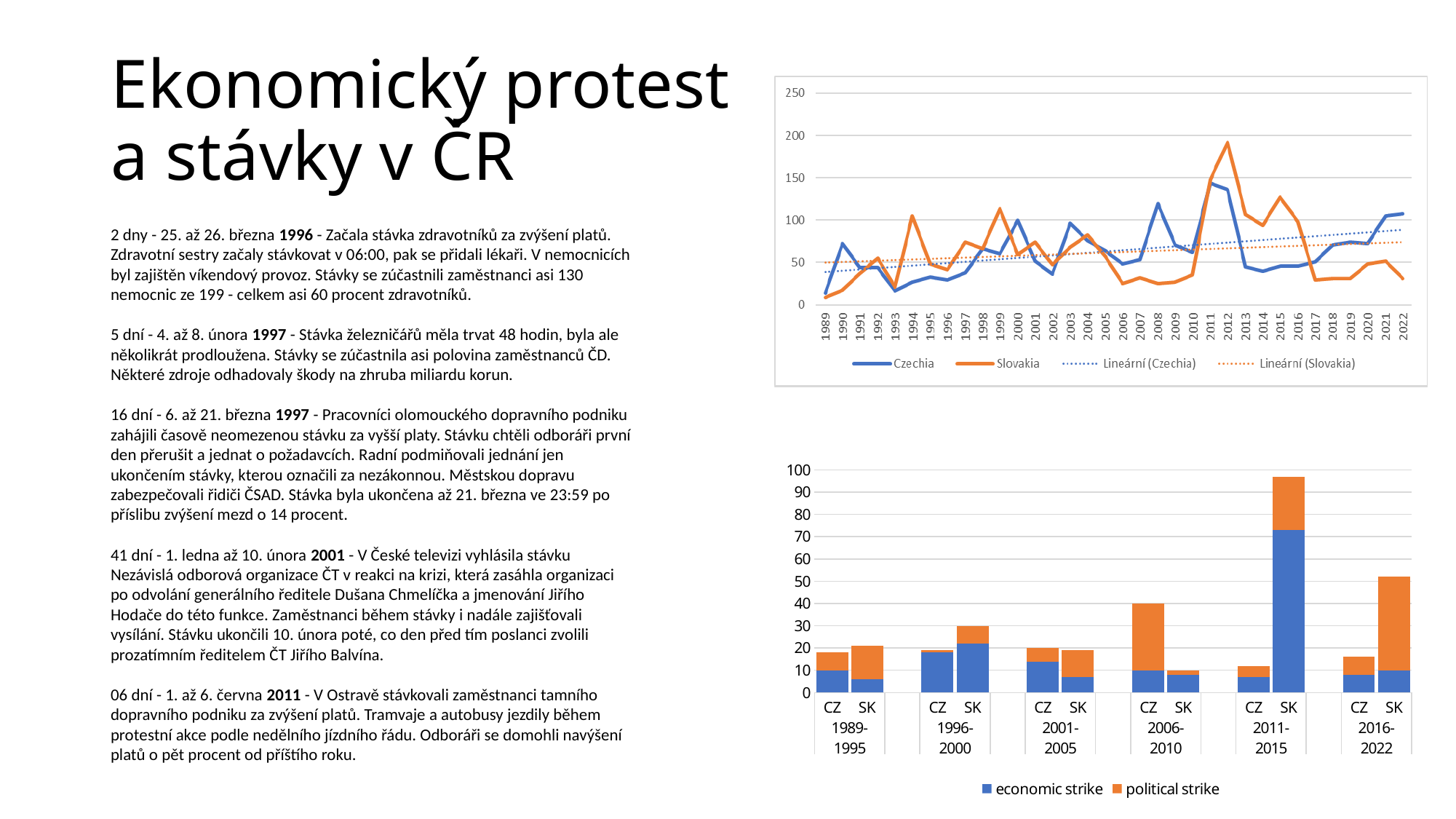
In the top line chart, is the value for Slovakia in 2022 greater or less than 50? less In the top line chart, do the linear trendlines for Czechia and Slovakia rise or fall over the years? rise In the bottom bar chart, which is larger in 2011-2015, the total for CZ or for SK? SK In the top line chart, in which year does the Slovakia series reach its highest value? 2012 In the top line chart, is the value for Slovakia in 2012 greater or less than 150? greater In the bottom bar chart, which bar has the highest total? SK 2011-2015 In the bottom bar chart, is the total for SK 2011-2015 greater or less than 90? greater In the bottom bar chart, how many series does the legend list? 2 What kind of chart is the bottom chart on the slide? bar chart What kind of chart is the top chart on the slide? line chart In the top line chart, how many entries does the legend list? 4